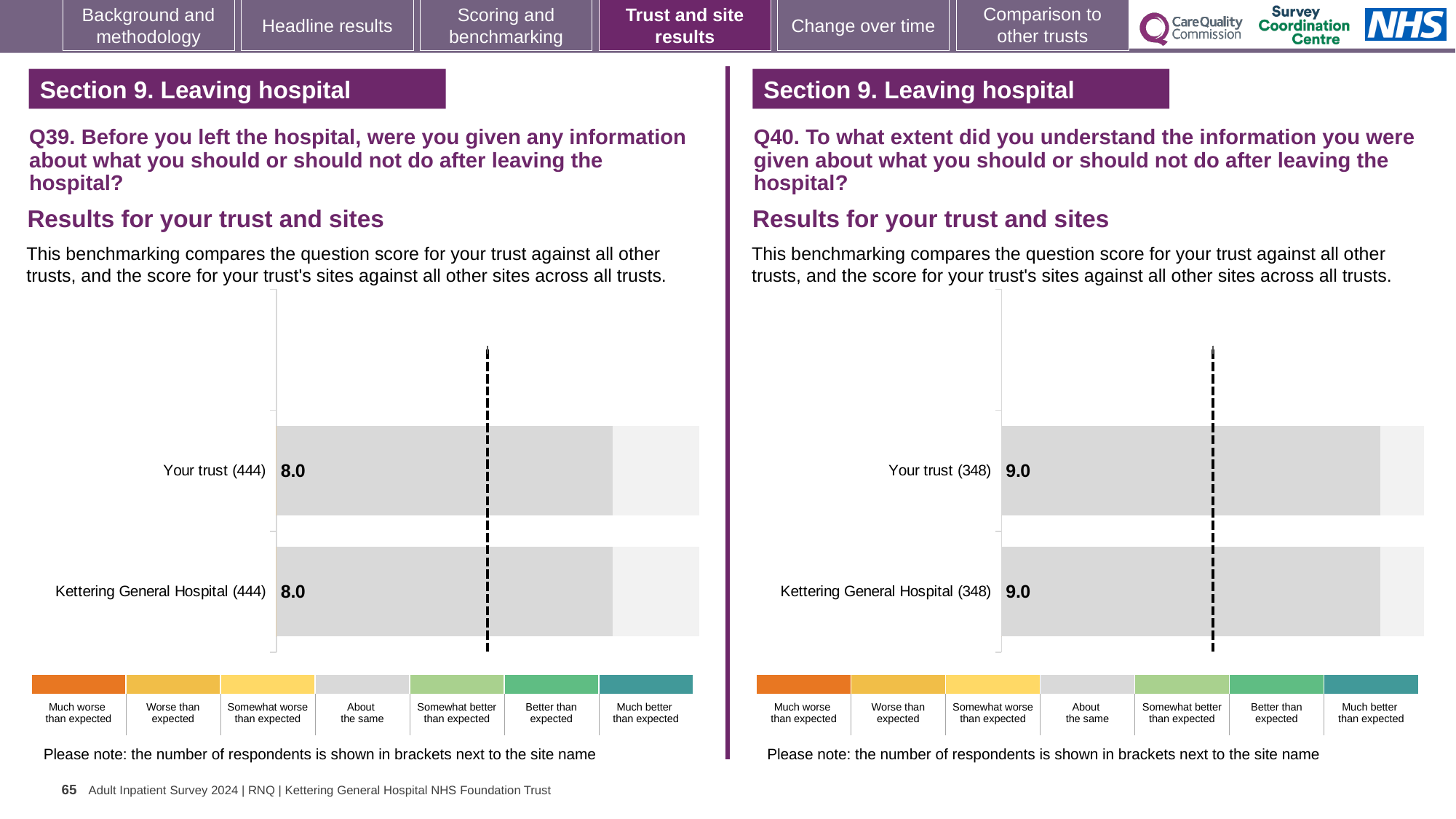
How many bars are plotted on the right chart (Q40)? 2 On the left chart (Q39), how many respondents are shown in brackets next to Your trust? 444 On the left chart (Q39), what is the score for Your trust? 8.0 On the right chart (Q40), what is the score for Your trust? 9.0 On the right chart (Q40), which benchmark category does the grey colour of the bars correspond to in the legend? About the same What kind of chart is used on the left (Q39)? Bar chart On the right chart (Q40), what is the score for Kettering General Hospital? 9.0 On the left chart (Q39), what is the difference between the score for Your trust and the score for Kettering General Hospital? 0.0 How many categories does the colour legend below the left chart (Q39) list? 7 How many bars are plotted on the left chart (Q39)? 2 On the right chart (Q40), how many respondents are shown in brackets next to Kettering General Hospital? 348 On the left chart (Q39), what is the score for Kettering General Hospital? 8.0